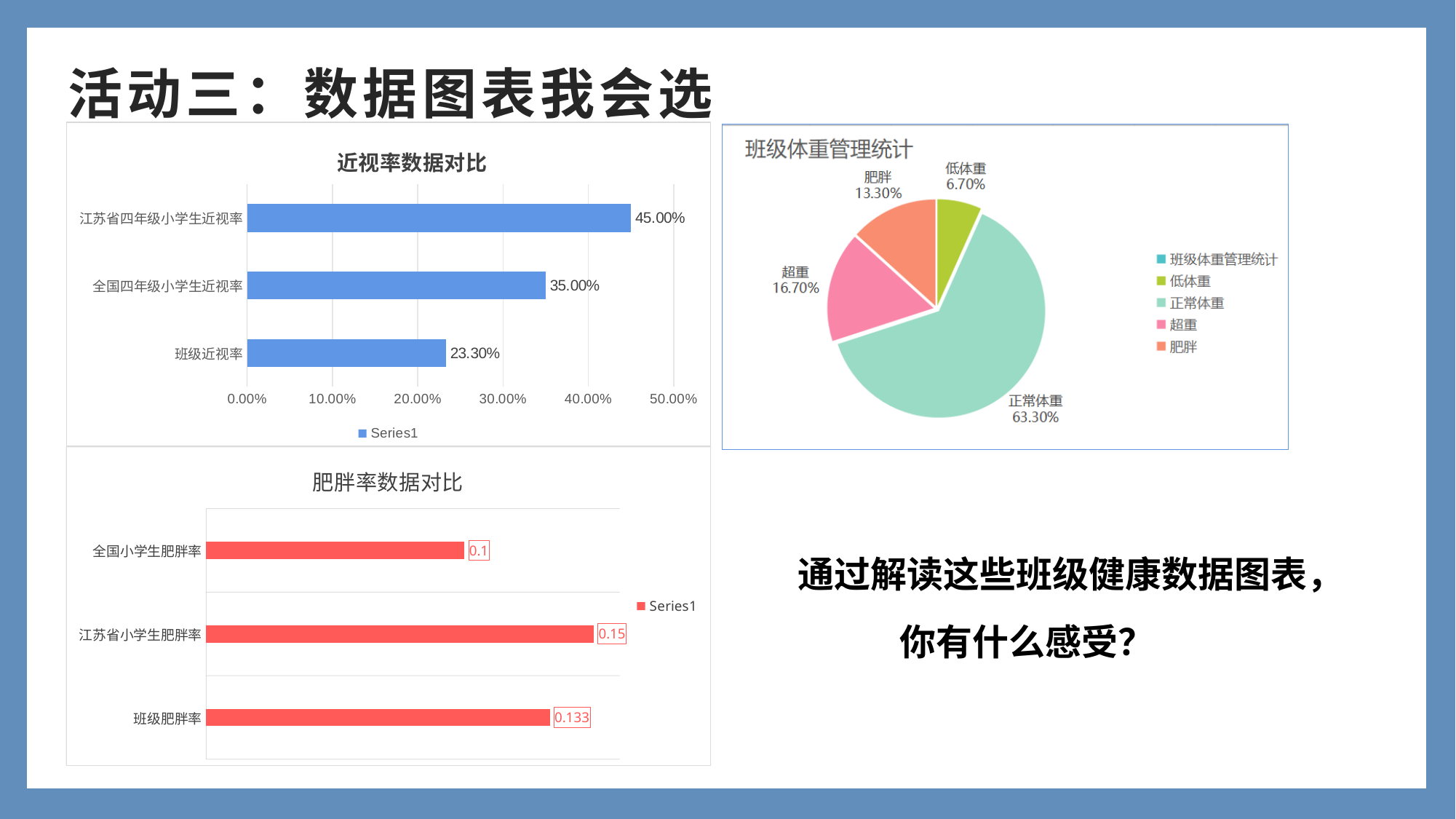
What kind of chart is 近视率数据对比? bar chart In the 班级体重管理统计 pie chart, what share does 正常体重 have? 63.30% In the 近视率数据对比 chart, what is the value for 江苏省四年级小学生近视率? 45.00% In the 肥胖率数据对比 chart, which category has the highest value? 江苏省小学生肥胖率 In the 肥胖率数据对比 chart, what is the value for 班级肥胖率? 0.133 In the 近视率数据对比 chart, what is the difference between 江苏省四年级小学生近视率 and 全国四年级小学生近视率? 10.00% In the 班级体重管理统计 pie chart, what is the difference between 超重 and 肥胖? 3.40% In the 班级体重管理统计 pie chart, which slice is the smallest? 低体重 In the 肥胖率数据对比 chart, which is larger, 全国小学生肥胖率 or 班级肥胖率? 班级肥胖率 What kind of chart is 班级体重管理统计? pie chart In the 近视率数据对比 chart, which category has the lowest value? 班级近视率 In the 近视率数据对比 chart, how many categories are shown? 3